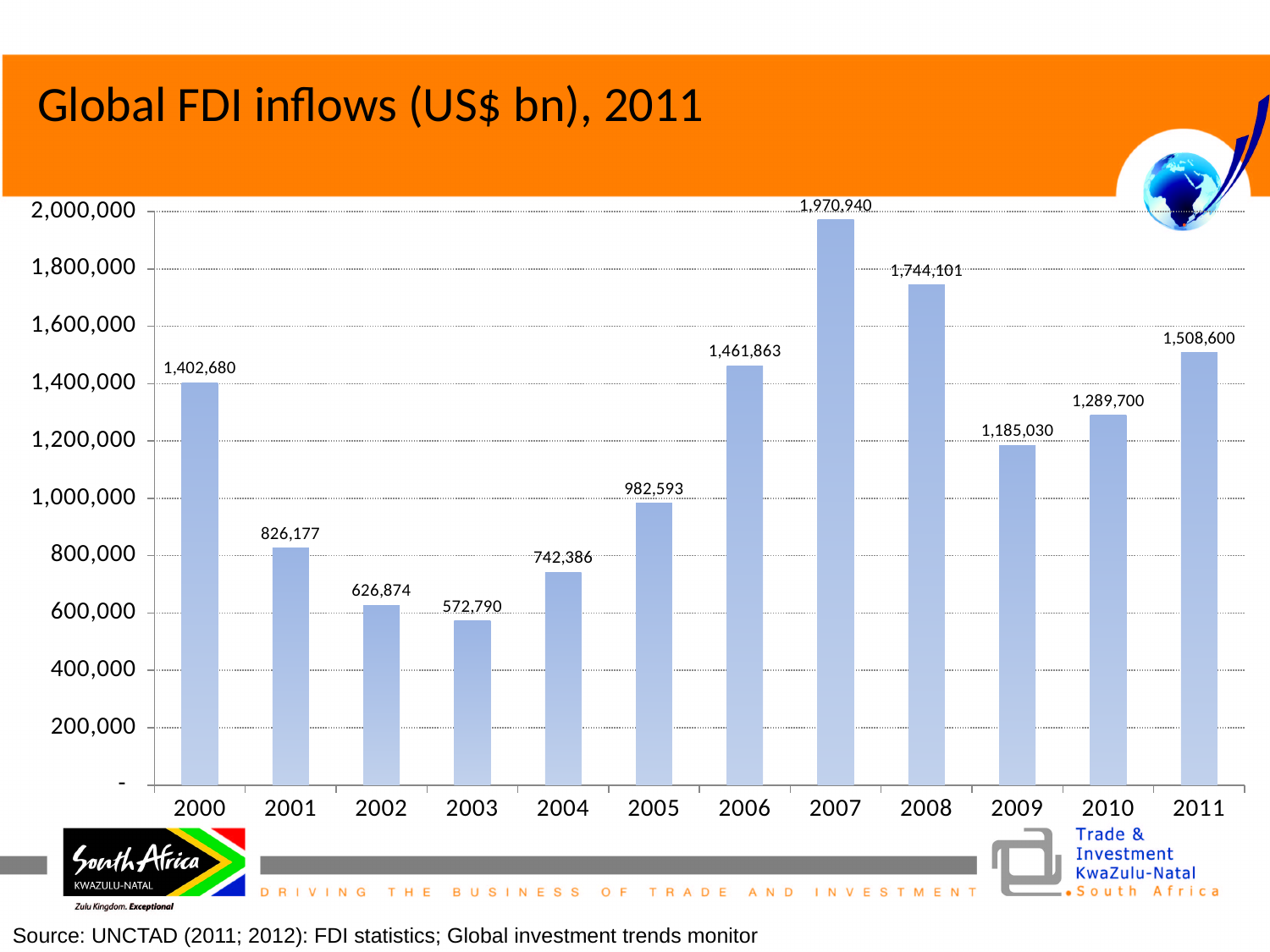
What is the value for 2003? 572,790 Which year has the lowest value? 2003 What is the value for 2007? 1,970,940 What is the difference between the values for 2007 and 2008? 226,839 What kind of chart is shown on the slide? bar chart How many years are shown on the x axis? 12 What is the value for 2011? 1,508,600 Which year has the highest value? 2007 Is the value for 2005 greater or less than 1,000,000? less Which is larger, the value for 2000 or the value for 2006? 2006 Do the values rise or fall from 2003 to 2007? rise What is the difference between the values for 2011 and 2010? 218,900